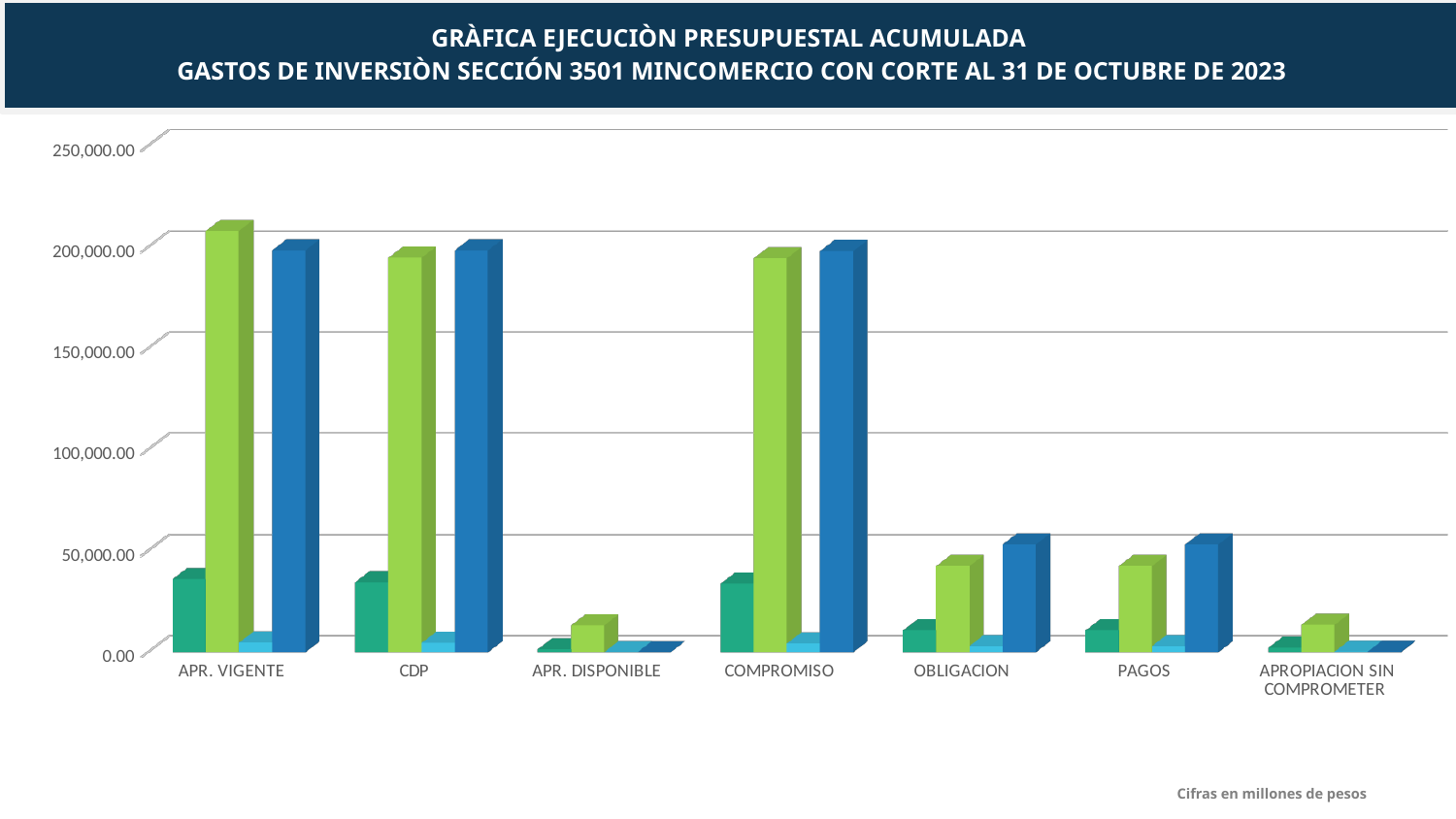
Is the value of the green bar for APR. DISPONIBLE greater or less than 50,000.00? less Which has the larger green bar, APR. VIGENTE or CDP? APR. VIGENTE Is the value of the green bar for COMPROMISO greater or less than 150,000.00? greater Is the value of the dark blue bar for PAGOS greater or less than 100,000.00? less According to the note on the slide, in what units are the figures expressed? millones de pesos Which category has the tallest bar on the chart? APR. VIGENTE What kind of chart is shown on the slide? bar chart Which has the larger green bar, OBLIGACION or APR. DISPONIBLE? OBLIGACION How many categories are shown along the x axis? 7